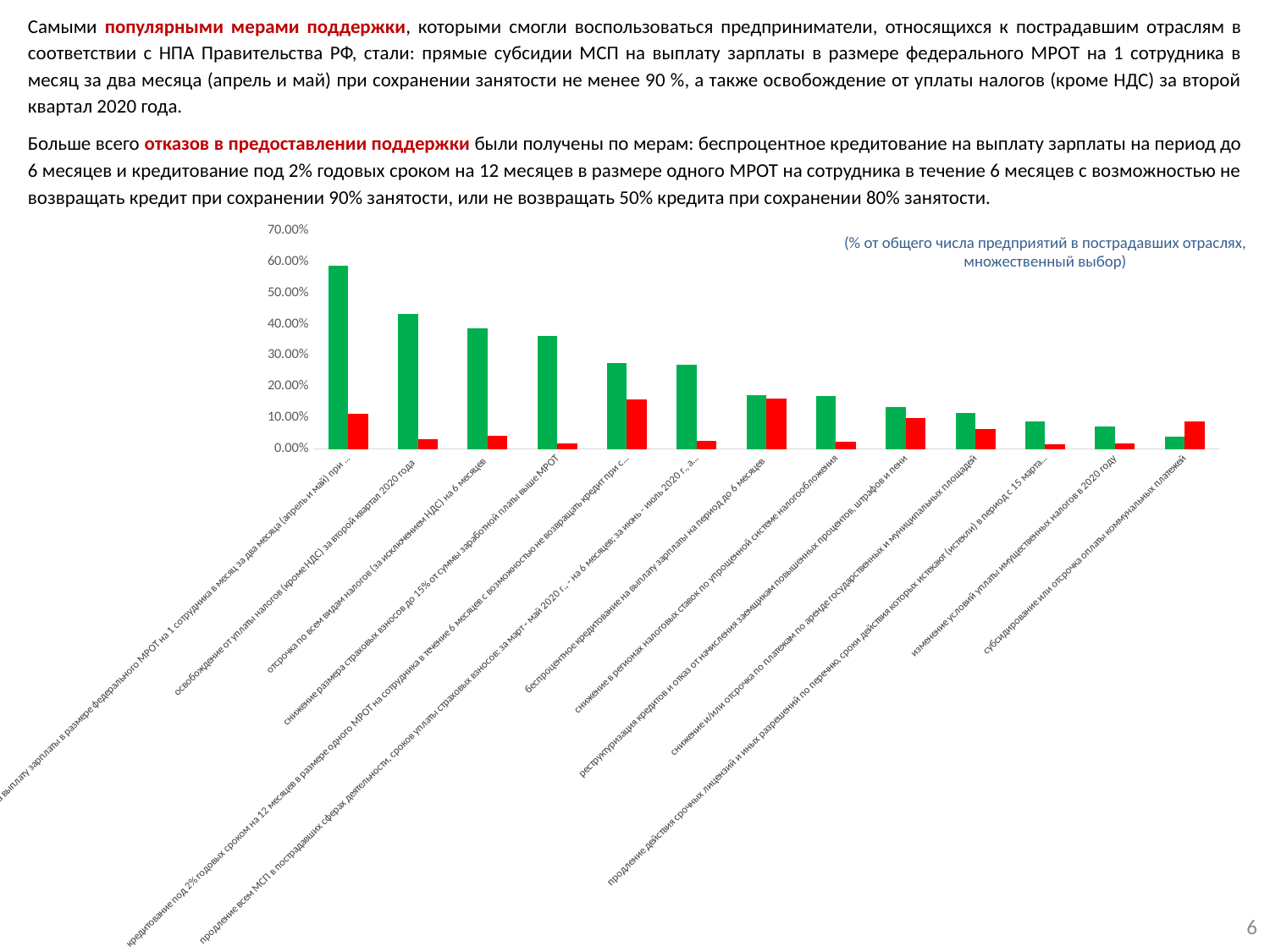
Which category has the shortest green bar? субсидирование или отсрочка оплаты коммунальных платежей What two colours are used for the bars in the chart? Green and red Which category has the tallest green bar? The leftmost category (subsidies for salary payment in the amount of the federal MROT per employee for April and May) Is the red bar for 'беспроцентное кредитование на выплату зарплаты на период до 6 месяцев' greater or less than 10.00%? greater Is the green bar for 'освобождение от уплаты налогов (кроме НДС) за второй квартал 2020 года' greater or less than 40.00%? greater What kind of chart is shown on the slide? Bar chart Is the green bar for 'отсрочка по всем видам налогов (за исключением НДС) на 6 месяцев' greater or less than 40.00%? less Which green bar is taller: 'освобождение от уплаты налогов (кроме НДС) за второй квартал 2020 года' or 'отсрочка по всем видам налогов (за исключением НДС) на 6 месяцев'? освобождение от уплаты налогов (кроме НДС) за второй квартал 2020 года Do the green bars generally rise or fall from left to right along the x axis? Fall How many categories (support measures) are plotted on the chart? 13